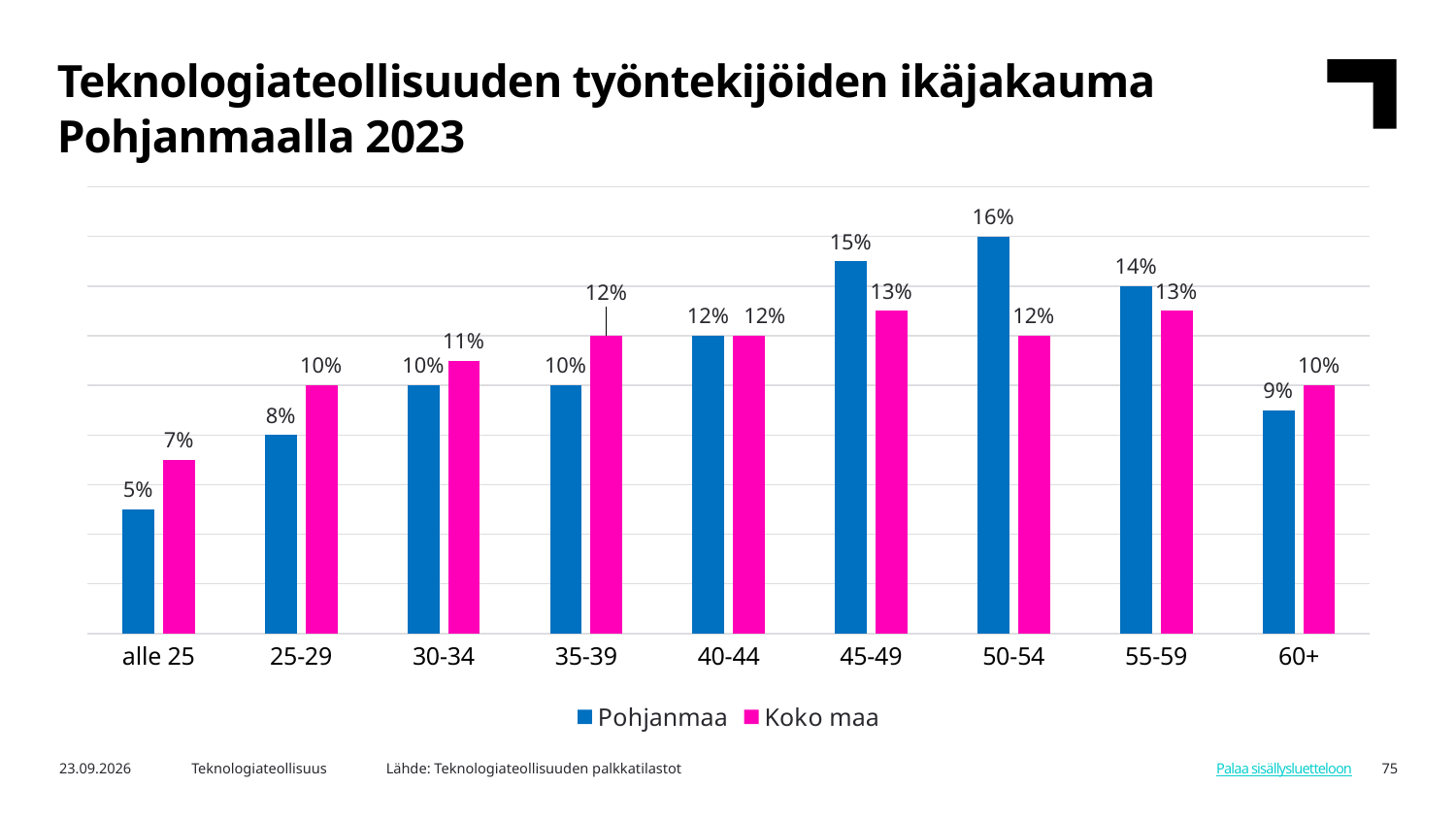
How many age groups are shown on the x axis? 9 Which is larger for the 35-39 age group, the Pohjanmaa value or the Koko maa value? Koko maa What is the Pohjanmaa value for the 60+ age group? 9% What kind of chart is shown on the slide? Bar chart How many series does the legend list? 2 Which age group has the lowest Koko maa value? alle 25 Which age group has the highest Pohjanmaa value? 50-54 Which age group has the lowest Pohjanmaa value? alle 25 What is the difference between the Pohjanmaa and Koko maa values for the 50-54 age group? 4 percentage points Which series is shown in pink in the legend? Koko maa What is the Pohjanmaa value for the 50-54 age group? 16% What is the Koko maa value for the alle 25 age group? 7%